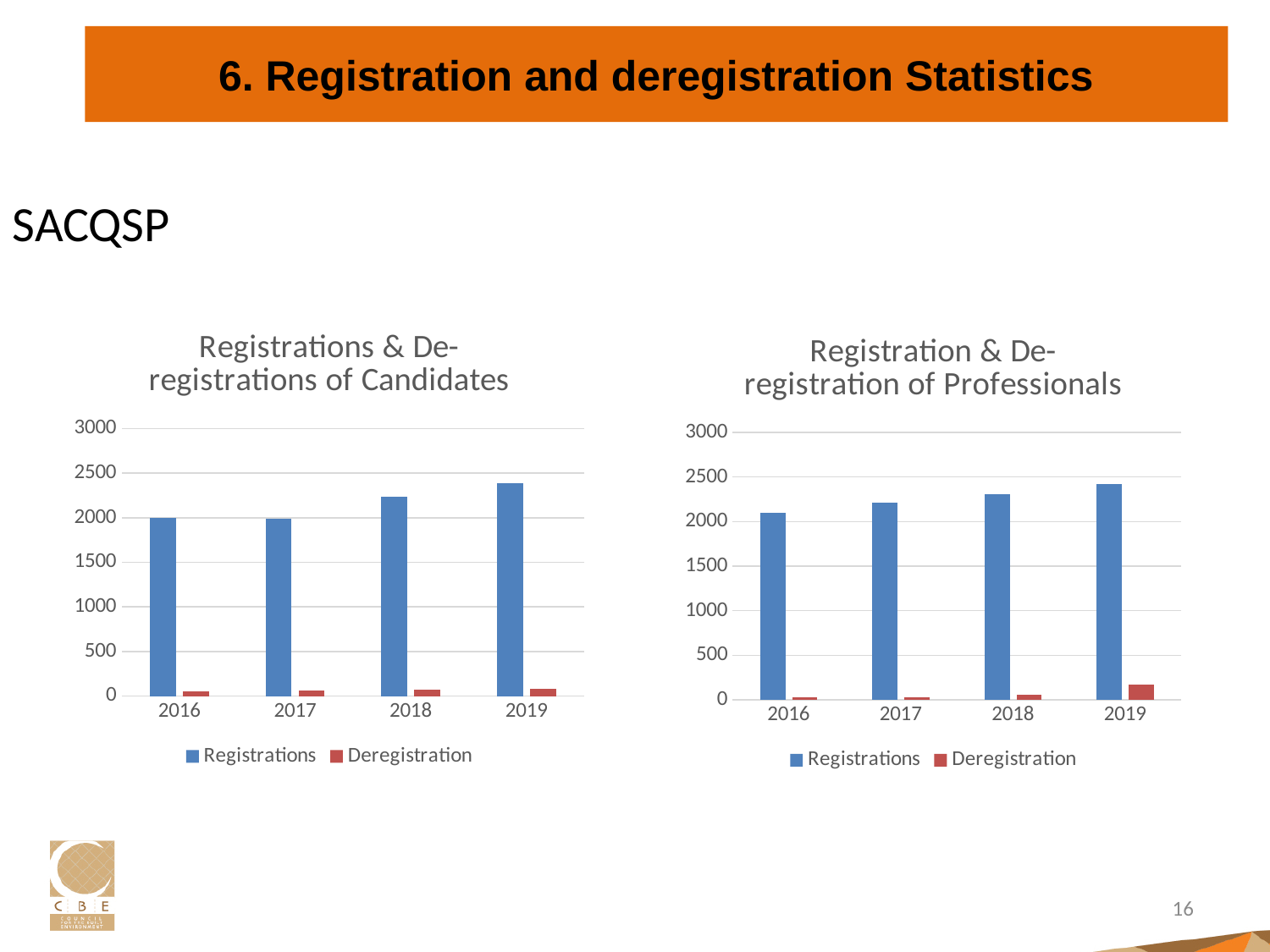
In the 'Registration & De-registration of Professionals' chart, what colour are the Deregistration bars? red In the 'Registration & De-registration of Professionals' chart, which is larger, the Deregistration value for 2019 or the Deregistration value for 2016? 2019 In the 'Registrations & De-registrations of Candidates' chart, how many series does the legend list? 2 In the 'Registration & De-registration of Professionals' chart, which year has the lowest Registrations value? 2016 In the 'Registration & De-registration of Professionals' chart, is the Registrations value for 2019 greater or less than 2500? less In the 'Registration & De-registration of Professionals' chart, which year has the highest Registrations value? 2019 In the 'Registrations & De-registrations of Candidates' chart, is the Deregistration value for 2018 greater or less than 500? less In the 'Registrations & De-registrations of Candidates' chart, how many years are shown on the x axis? 4 In the 'Registrations & De-registrations of Candidates' chart, which year has the highest Registrations value? 2019 In the 'Registration & De-registration of Professionals' chart, do the Registrations values rise or fall from 2016 to 2019? rise In the 'Registrations & De-registrations of Candidates' chart, is the Registrations value for 2019 greater or less than 2000? greater In the 'Registrations & De-registrations of Candidates' chart, what kind of chart is shown? bar chart